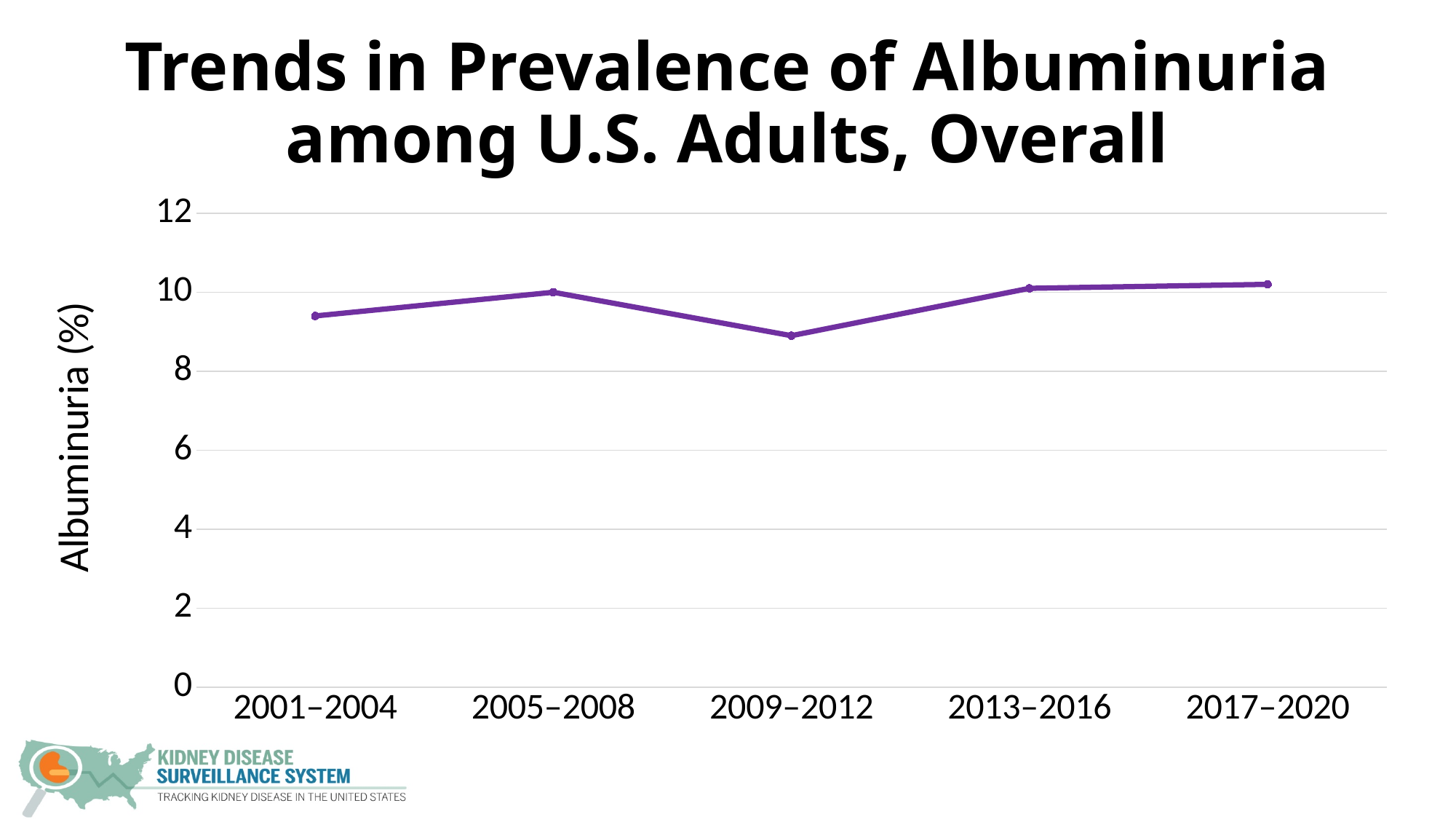
What is the title of the chart? Trends in Prevalence of Albuminuria among U.S. Adults, Overall From 2009–2012 to 2017–2020, does the albuminuria prevalence rise or fall? rise Which time period has the lowest albuminuria prevalence? 2009–2012 Is the value for 2009–2012 greater or less than 8? greater Is the value for 2017–2020 greater or less than 10? greater What kind of chart is shown on the slide? line chart Is the value for 2009–2012 greater or less than 10? less Which is larger, the value for 2001–2004 or the value for 2009–2012? 2001–2004 Which is larger, the value for 2005–2008 or the value for 2009–2012? 2005–2008 How many time periods are plotted on the x axis? 5 What is the label on the y axis? Albuminuria (%)